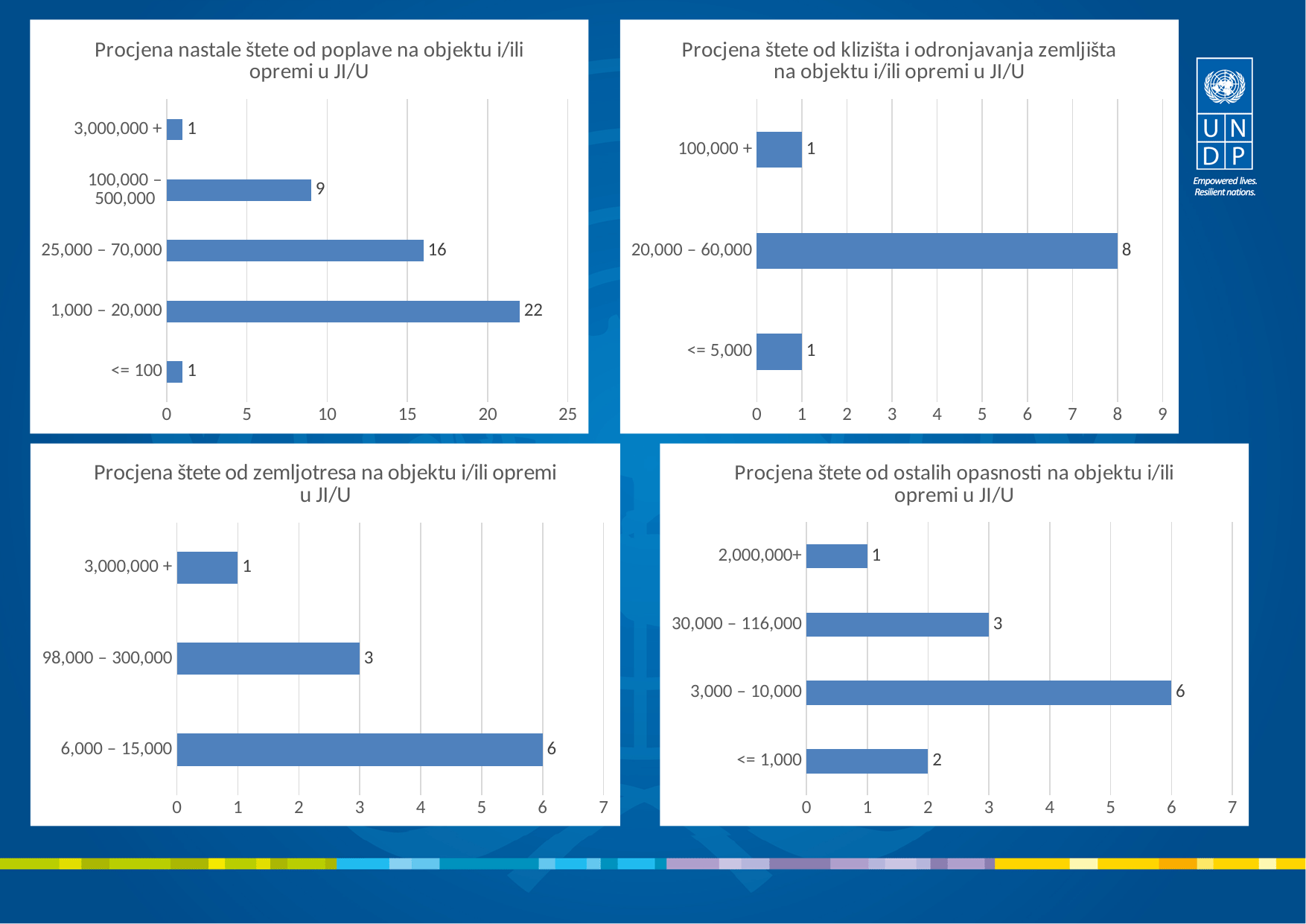
In the bottom-left chart (Procjena štete od zemljotresa), what is the value for the 98,000 – 300,000 category? 3 In the bottom-right chart (Procjena štete od ostalih opasnosti), which is larger: the value for 3,000 – 10,000 or the value for 30,000 – 116,000? 3,000 – 10,000 In the bottom-right chart (Procjena štete od ostalih opasnosti), what is the value for the <= 1,000 category? 2 What type of chart is the bottom-right chart (Procjena štete od ostalih opasnosti)? Bar chart In the top-left chart (Procjena nastale štete od poplave), what is the difference between the values for 25,000 – 70,000 and 100,000 – 500,000? 7 In the top-left chart (Procjena nastale štete od poplave), which category has the highest value? 1,000 – 20,000 In the top-left chart (Procjena nastale štete od poplave), what is the value for the 1,000 – 20,000 category? 22 In the bottom-left chart (Procjena štete od zemljotresa), which category has the lowest value? 3,000,000 + In the top-right chart (Procjena štete od klizišta i odronjavanja zemljišta), what is the value for the 20,000 – 60,000 category? 8 How many categories are shown in the top-right chart (Procjena štete od klizišta i odronjavanja zemljišta)? 3 How many charts are shown on the slide? 4 How many categories are shown in the top-left chart (Procjena nastale štete od poplave)? 5